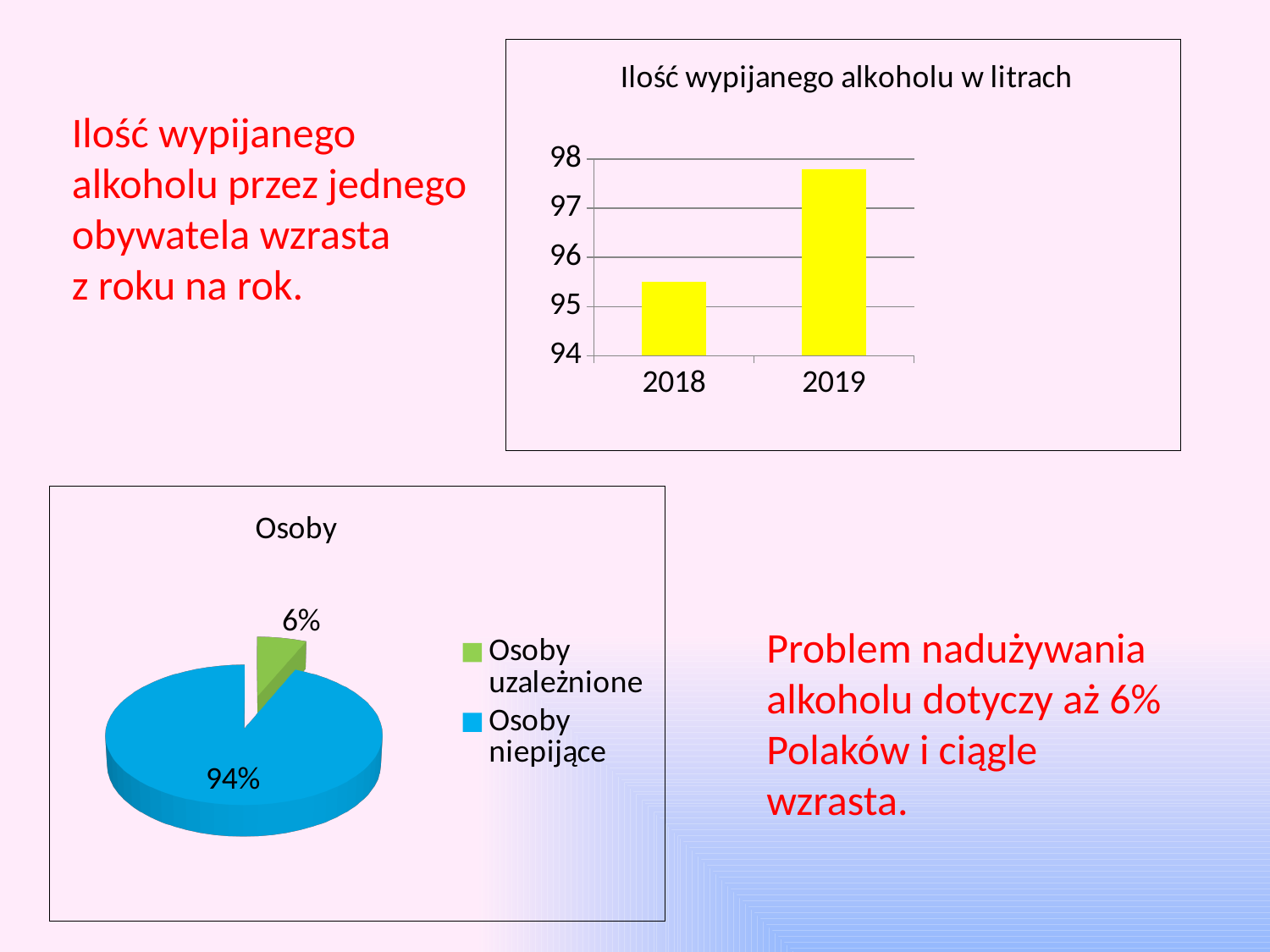
What kind of chart is the one titled 'Ilość wypijanego alkoholu w litrach'? bar chart In the chart titled 'Ilość wypijanego alkoholu w litrach', which year has the lower value? 2018 In the chart titled 'Osoby', what share of the pie is 'Osoby niepijące'? 94% In the chart titled 'Ilość wypijanego alkoholu w litrach', is the value for 2019 greater or less than 97? greater In the chart titled 'Ilość wypijanego alkoholu w litrach', do the values rise or fall from 2018 to 2019? rise In the chart titled 'Osoby', what share of the pie is 'Osoby uzależnione'? 6% In the chart titled 'Ilość wypijanego alkoholu w litrach', which year has the higher value? 2019 What kind of chart is the one titled 'Osoby'? pie chart In the chart titled 'Ilość wypijanego alkoholu w litrach', is the value for 2018 greater or less than 96? less In the chart titled 'Ilość wypijanego alkoholu w litrach', is the value for 2018 greater or less than 95? greater In the chart titled 'Ilość wypijanego alkoholu w litrach', how many years are shown on the x axis? 2 In the chart titled 'Osoby', how many entries does the legend list? 2